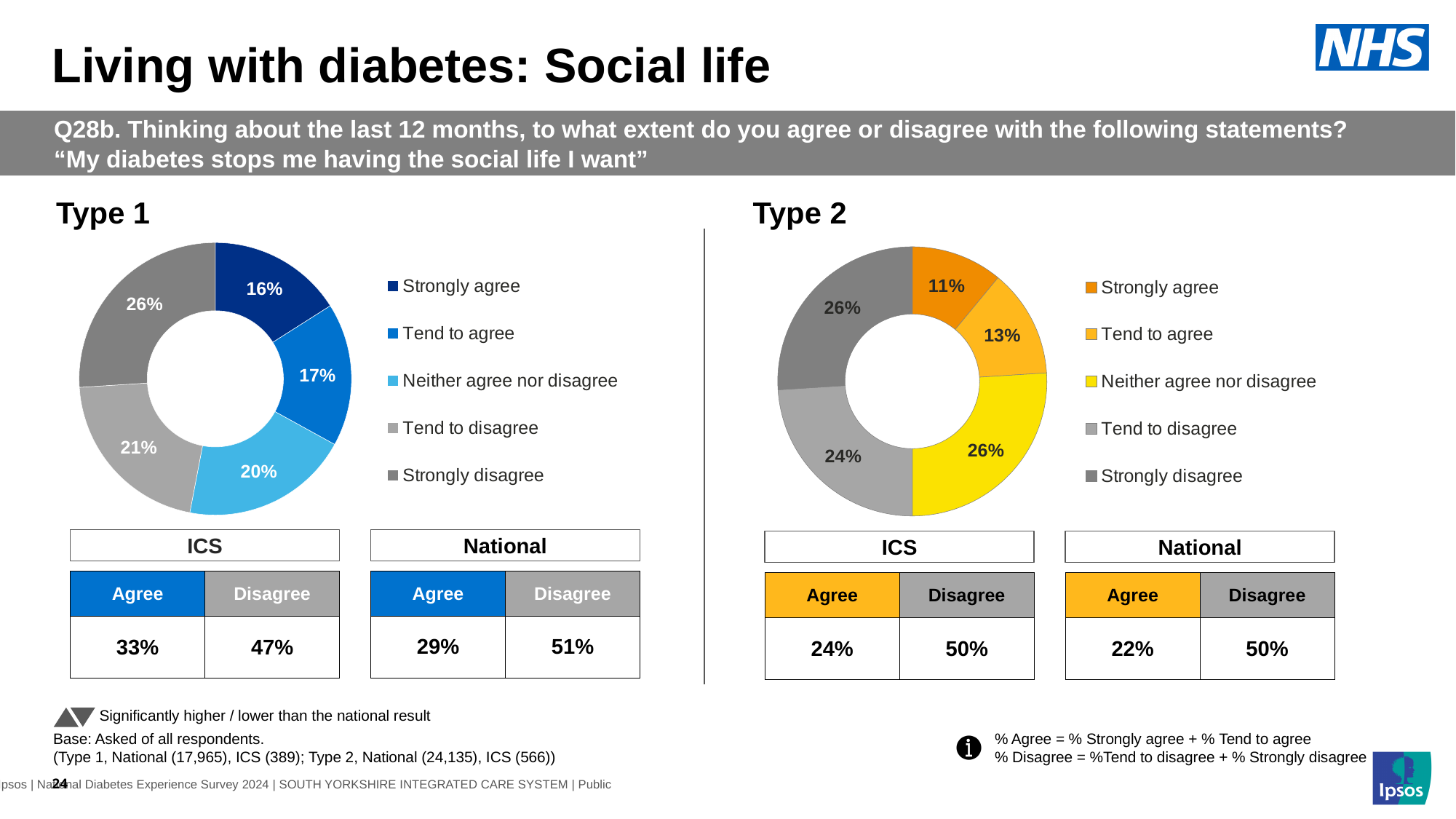
In the Type 1 chart, what percentage of respondents said 'Tend to disagree'? 21% In the Type 2 chart, which is larger: 'Tend to disagree' or 'Tend to agree'? Tend to disagree In the Type 1 chart, what is the difference between the 'Strongly disagree' and 'Strongly agree' shares? 10% What type of chart is used to show the Type 1 results? Donut chart In the Type 1 chart, which response category has the smallest share? Strongly agree In the Type 2 chart, what colour represents 'Neither agree nor disagree'? Yellow How many response categories does the Type 2 chart's legend list? 5 In the Type 2 chart, what percentage of respondents said 'Neither agree nor disagree'? 26% In the Type 1 chart, what percentage of respondents said 'Strongly agree'? 16% In the Type 2 chart, what percentage of respondents said 'Tend to agree'? 13% In the Type 1 chart, which response category has the largest share? Strongly disagree In the Type 2 chart, which response category has the smallest share? Strongly agree